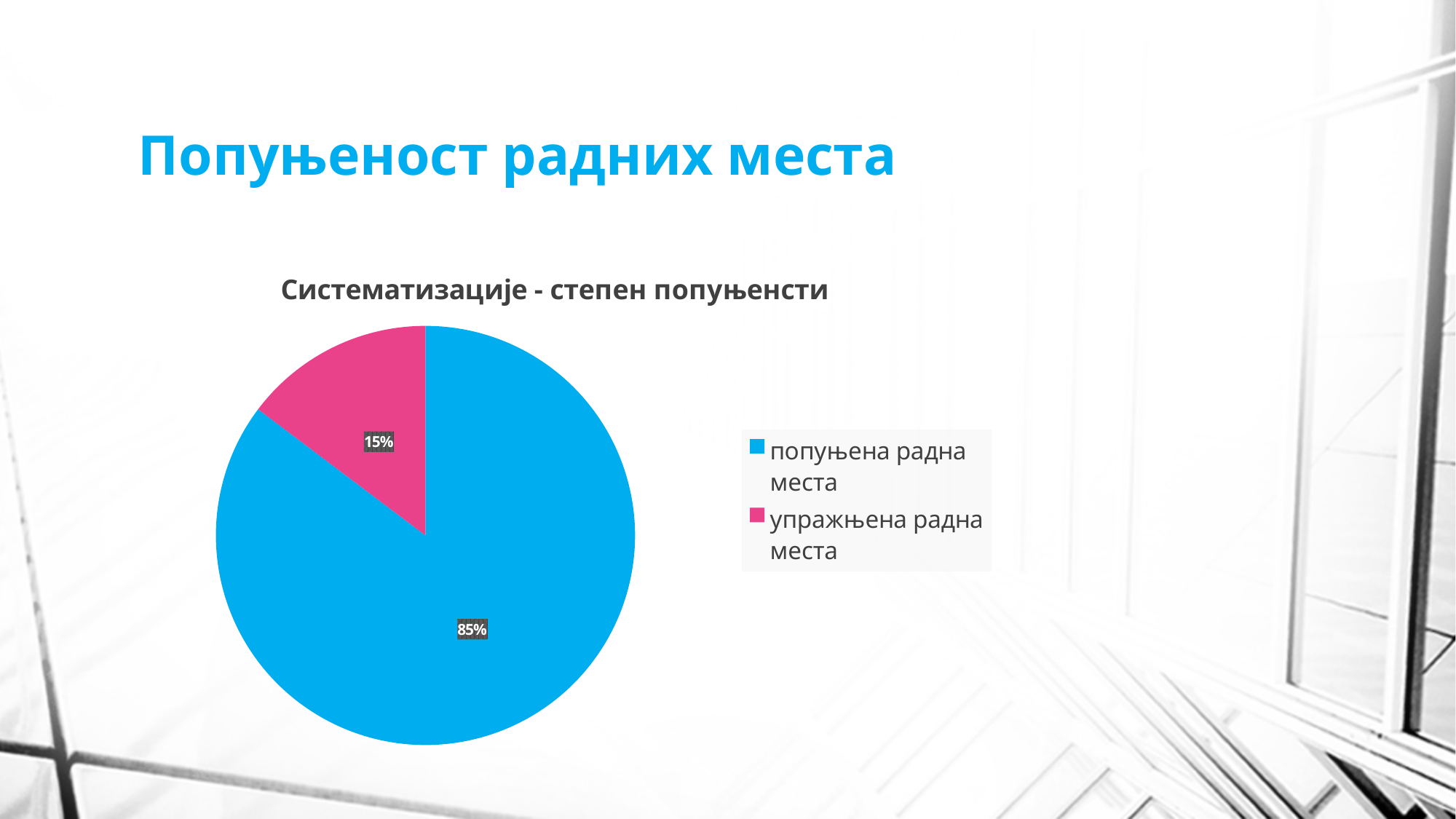
What share of the pie is labelled 'попуњена радна места'? 85% What share of the pie is labelled 'упражњена радна места'? 15% What is the difference in percentage points between 'попуњена радна места' and 'упражњена радна места'? 70 Which category has the largest slice of the pie? попуњена радна места How many entries does the legend list? 2 Which category has the smallest slice of the pie? упражњена радна места What type of chart is shown on the slide? pie chart Which is larger: the slice for 'попуњена радна места' or the slice for 'упражњена радна места'? попуњена радна места What is the title of the chart? Систематизације - степен попуњенсти What colour is the slice for 'упражњена радна места'? pink How many slices does the pie chart have? 2